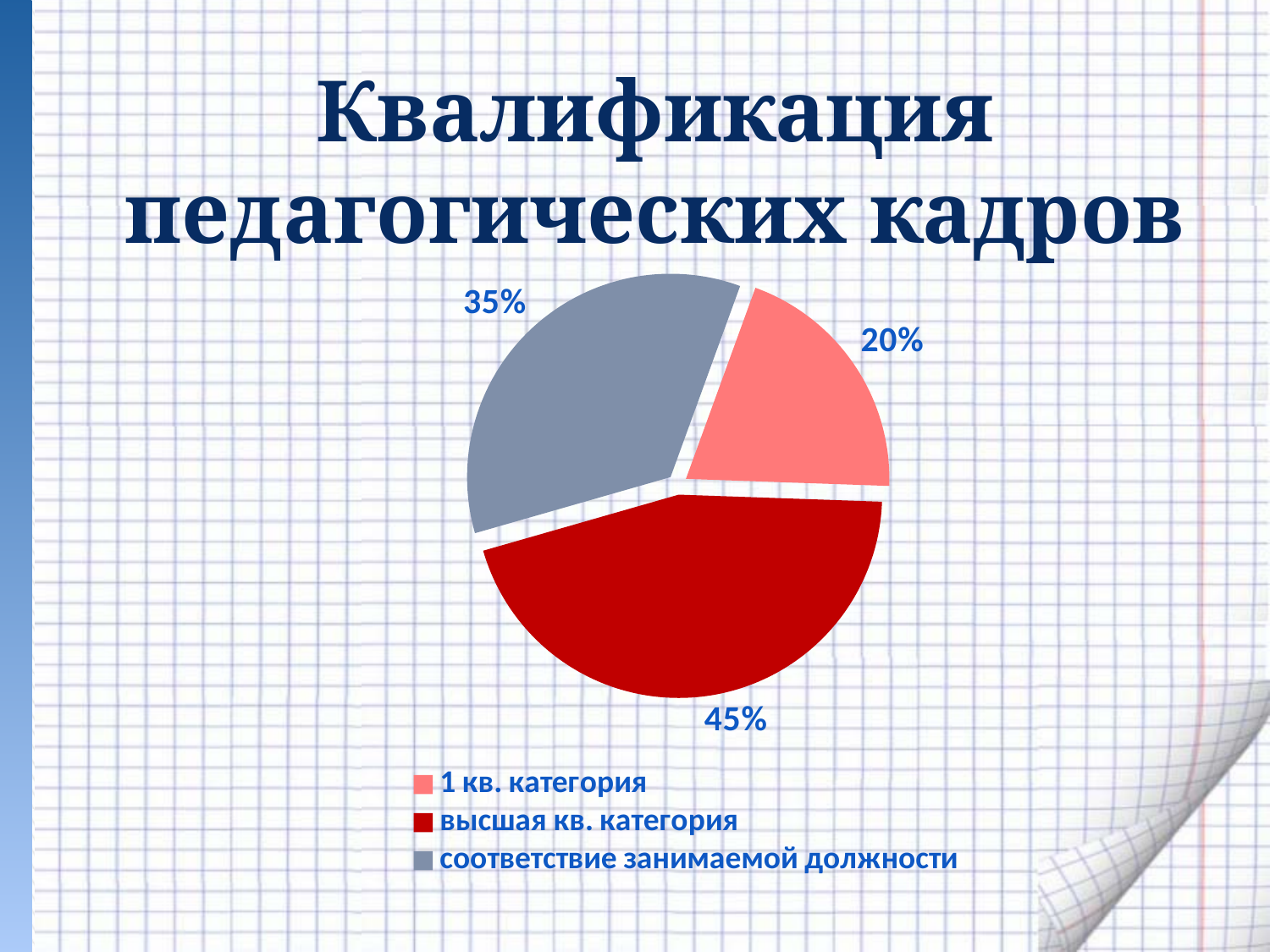
Which is larger: the share for "соответствие занимаемой должности" or the share for "1 кв. категория"? соответствие занимаемой должности What share of the pie does "высшая кв. категория" have? 45% What is the difference in percentage points between "высшая кв. категория" and "1 кв. категория"? 25% What is the title of the slide containing the chart? Квалификация педагогических кадров Which category has the largest slice of the pie? высшая кв. категория What colour is the slice for "соответствие занимаемой должности"? grey What share of the pie does "1 кв. категория" have? 20% What is the difference in percentage points between "высшая кв. категория" and "соответствие занимаемой должности"? 10% What share of the pie does "соответствие занимаемой должности" have? 35% Which category has the smallest slice of the pie? 1 кв. категория What kind of chart is shown on the slide? pie chart How many slices does the pie chart have? 3